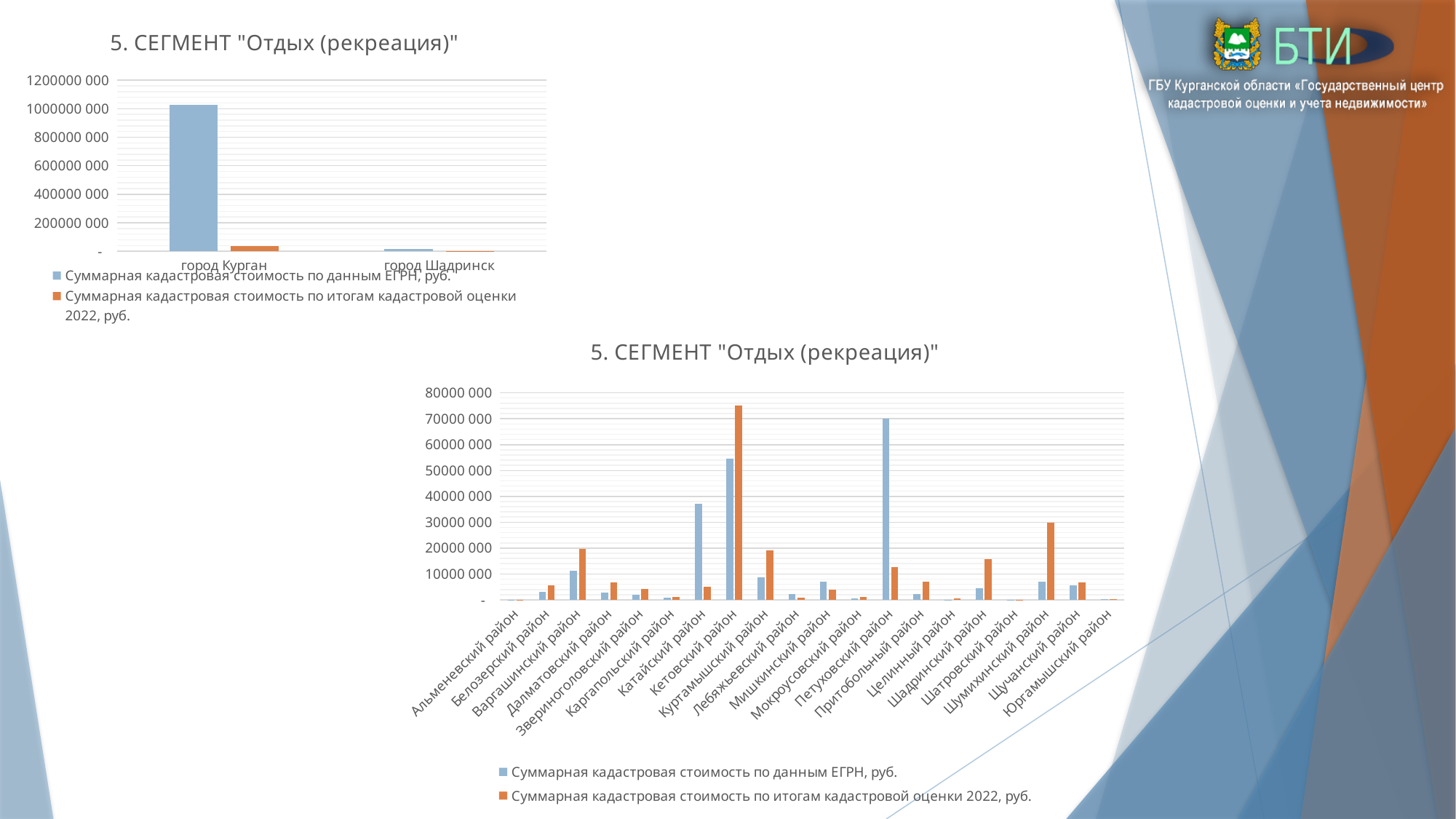
How many categories (districts) are shown on the x axis of the bottom-right chart? 20 How many series does the legend of the bottom-right chart list? 2 In the top-left chart, is the value for город Курган in the series 'Суммарная кадастровая стоимость по данным ЕГРН, руб.' greater or less than 800000 000? greater How many categories are shown on the x axis of the top-left chart? 2 In the top-left chart, which category has the highest value for 'Суммарная кадастровая стоимость по данным ЕГРН, руб.'? город Курган What type of chart is the top-left chart on the slide? bar chart In the bottom-right chart, for Петуховский район, which series has the larger value: 'по данным ЕГРН' or 'по итогам кадастровой оценки 2022'? по данным ЕГРН In the bottom-right chart, is the value for Кетовский район in the series 'Суммарная кадастровая стоимость по итогам кадастровой оценки 2022, руб.' greater or less than 70000 000? greater In the bottom-right chart, which district has the highest value for 'Суммарная кадастровая стоимость по итогам кадастровой оценки 2022, руб.'? Кетовский район In the bottom-right chart, which colour represents the series 'Суммарная кадастровая стоимость по данным ЕГРН, руб.'? blue In the bottom-right chart, which district has the highest value for 'Суммарная кадастровая стоимость по данным ЕГРН, руб.'? Петуховский район In the bottom-right chart, is the value for Катайский район in the series 'Суммарная кадастровая стоимость по данным ЕГРН, руб.' greater or less than 30000 000? greater